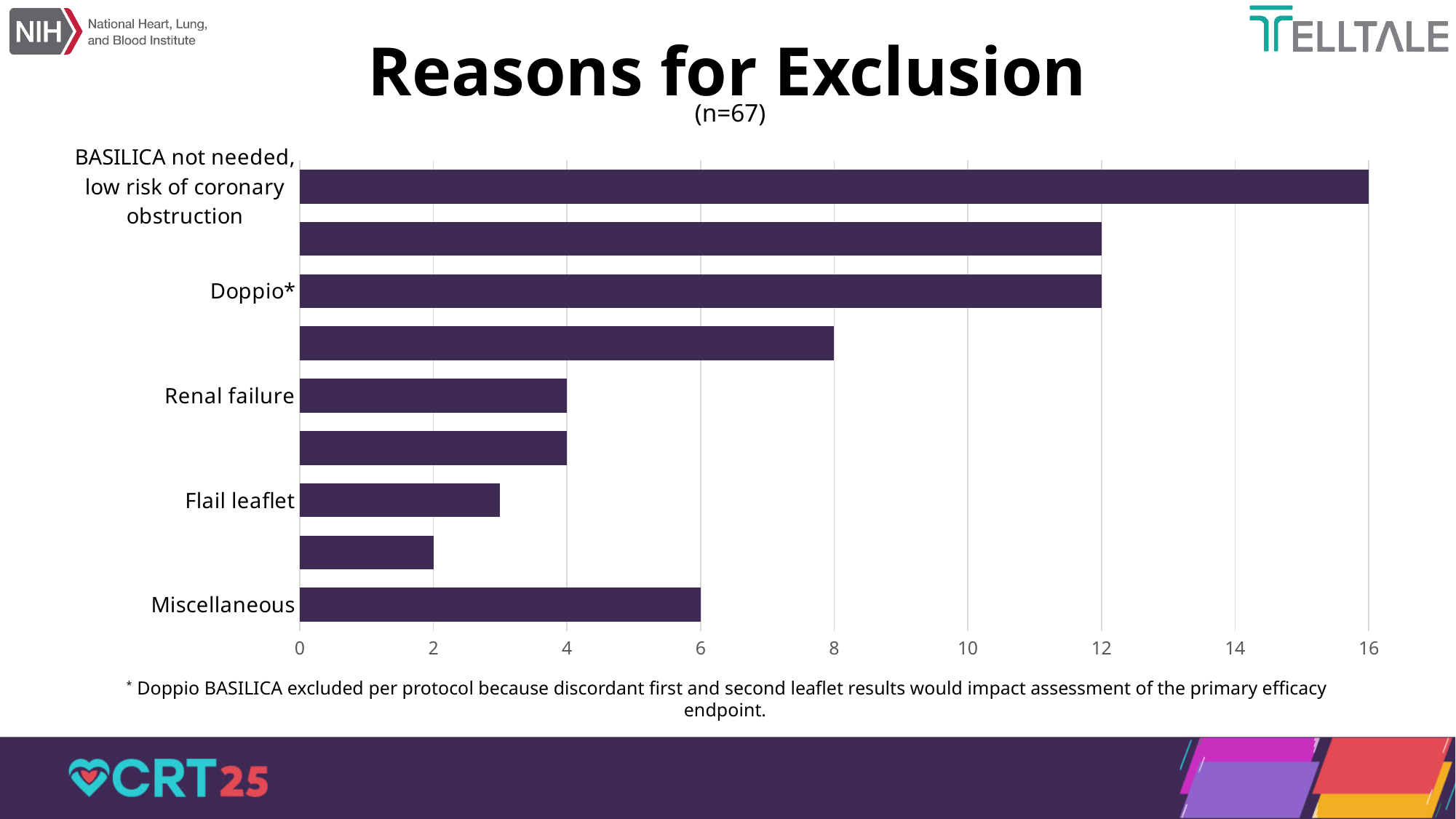
Which category has the highest value? BASILICA not needed, low risk of coronary obstruction What is the title of the chart? Reasons for Exclusion What is the difference between the values for 'BASILICA not needed, low risk of coronary obstruction' and Doppio*? 4 What is the value for 'BASILICA not needed, low risk of coronary obstruction'? 16 Which is larger, the value for Renal failure or the value for Miscellaneous? Miscellaneous What is the value for Renal failure? 4 How many bars are plotted in the chart? 9 What is the value for Doppio*? 12 Is the value for Flail leaflet greater or less than 4? less What is the difference between the values for Miscellaneous and Renal failure? 2 What is the value for Miscellaneous? 6 What kind of chart is shown on the slide? bar chart